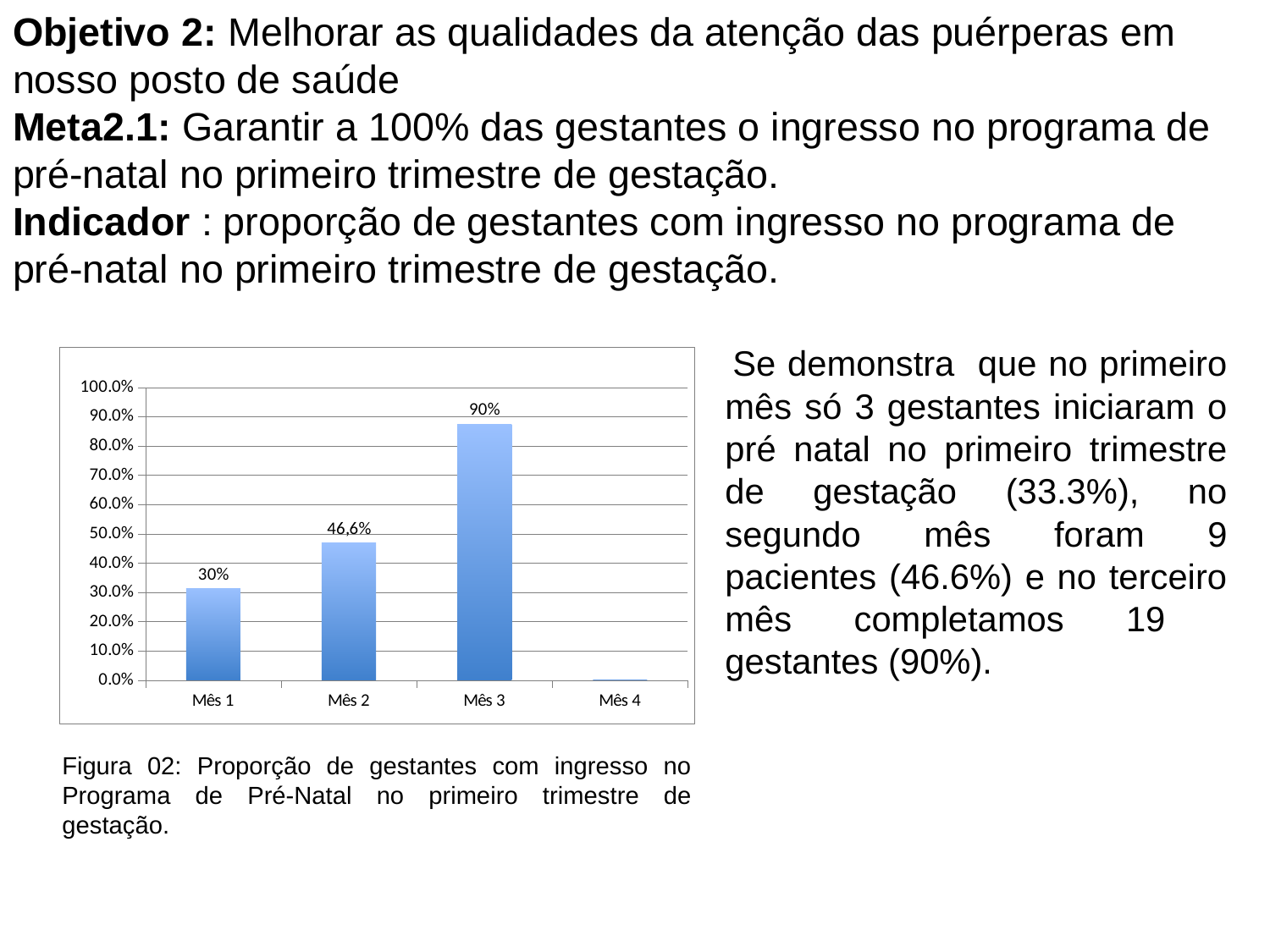
Is the value for Mês 3 greater or less than 80.0%? greater Is the value for Mês 1 greater or less than 20.0%? greater What value is labelled on the bar for Mês 2? 46,6% What value is labelled on the bar for Mês 3? 90% Which month has the lowest value in the chart? Mês 4 Do the values rise or fall from Mês 1 to Mês 3? Rise What value is labelled on the bar for Mês 1? 30% How many month categories are shown on the x axis of the chart? 4 What kind of chart is shown on the slide? Bar chart Which month has the highest bar in the chart? Mês 3 What is the difference between the labelled values for Mês 3 and Mês 1? 60% Which is larger, the value for Mês 2 or the value for Mês 1? Mês 2